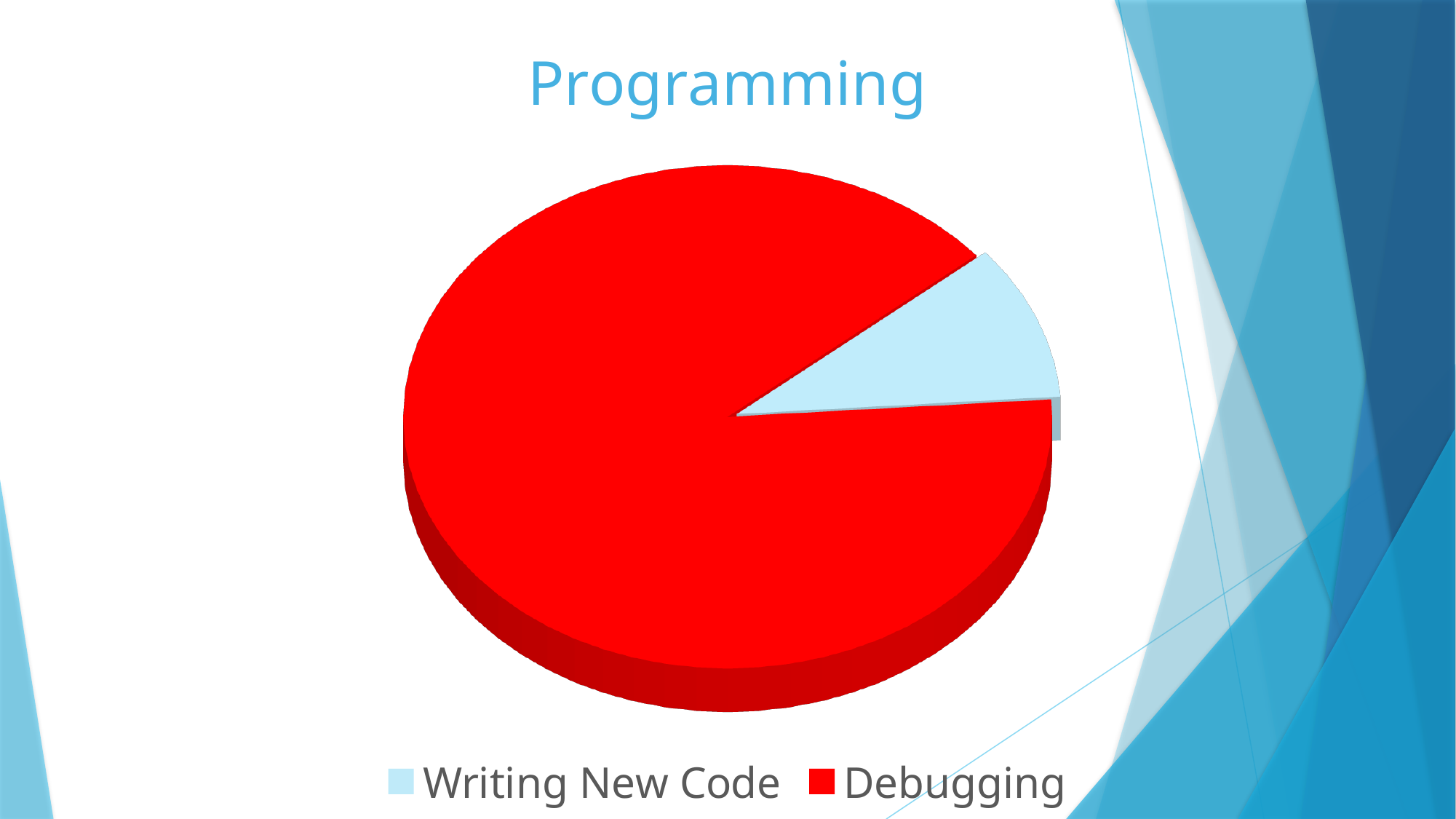
Which slice is the largest in the pie chart? Debugging How many slices does the pie chart have? 2 What kind of chart is shown on the slide? pie chart How many entries does the legend list? 2 What colour is the Debugging slice? red Which legend entry is shown in light blue? Writing New Code What is the title of the chart? Programming Which is larger, the Debugging slice or the Writing New Code slice? Debugging Which slice is the smallest in the pie chart? Writing New Code